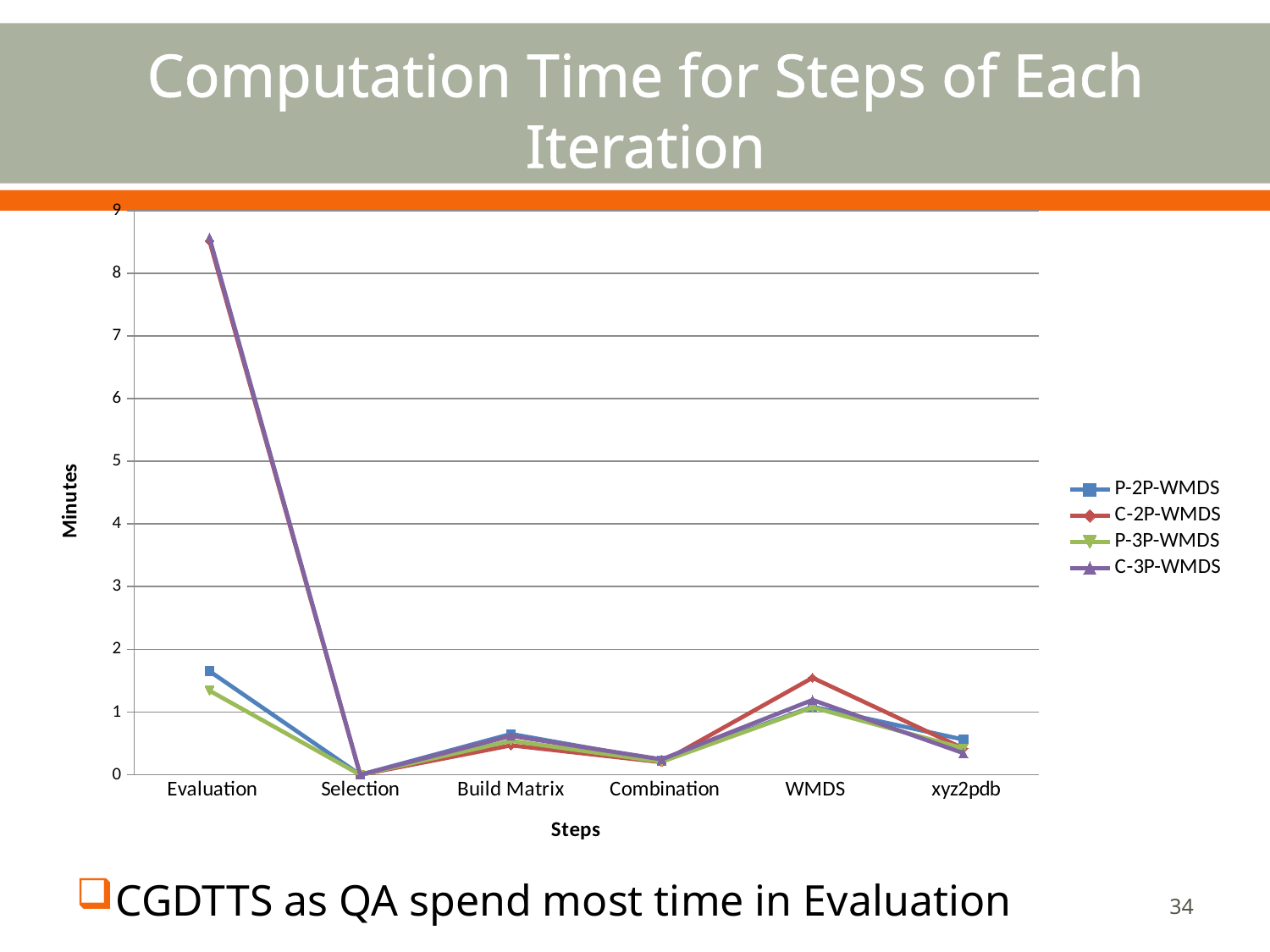
Is the value for P-2P-WMDS at Evaluation greater or less than 2? less What kind of chart is shown on the slide? line chart For the C-2P-WMDS series, which step has the lowest computation time? Selection How many steps are shown along the x axis? 6 How many series does the legend list? 4 Is the value for C-3P-WMDS at Evaluation greater or less than 8? greater For the C-2P-WMDS series, which step has the highest computation time? Evaluation At the WMDS step, which series has the higher value: C-2P-WMDS or P-3P-WMDS? C-2P-WMDS Is the value for C-2P-WMDS at WMDS greater or less than 1? greater At the Evaluation step, which series has the higher value: C-2P-WMDS or P-2P-WMDS? C-2P-WMDS Does the C-3P-WMDS series rise or fall from Evaluation to Selection? fall What is the label on the y axis of the chart? Minutes